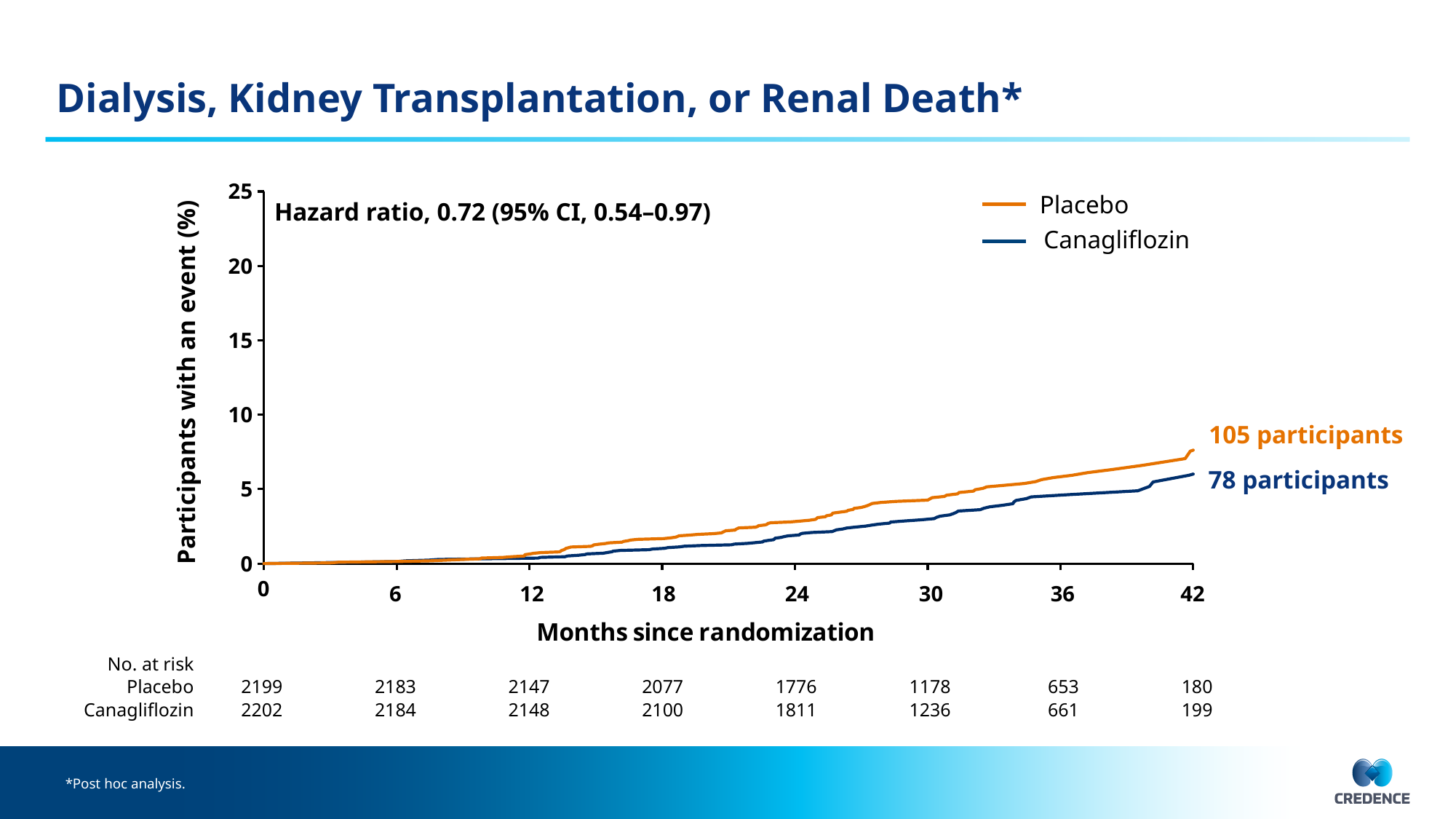
What is the number at risk for Canagliflozin at 42 months? 199 What kind of chart is shown on the slide? Line chart Which group has the higher percentage of participants with an event at 42 months, Placebo or Canagliflozin? Placebo Is the value for Placebo at 42 months greater or less than 10%? less Do the curves rise or fall as months since randomization increase? Rise How many participants had an event in the Placebo group? 105 participants Is the value for Canagliflozin at 42 months greater or less than 5%? greater What is the hazard ratio printed on the chart? 0.72 (95% CI, 0.54–0.97) How many participants had an event in the Canagliflozin group? 78 participants How many series does the legend list? 2 Which series is drawn in orange? Placebo What is the number at risk for Placebo at 24 months? 1776